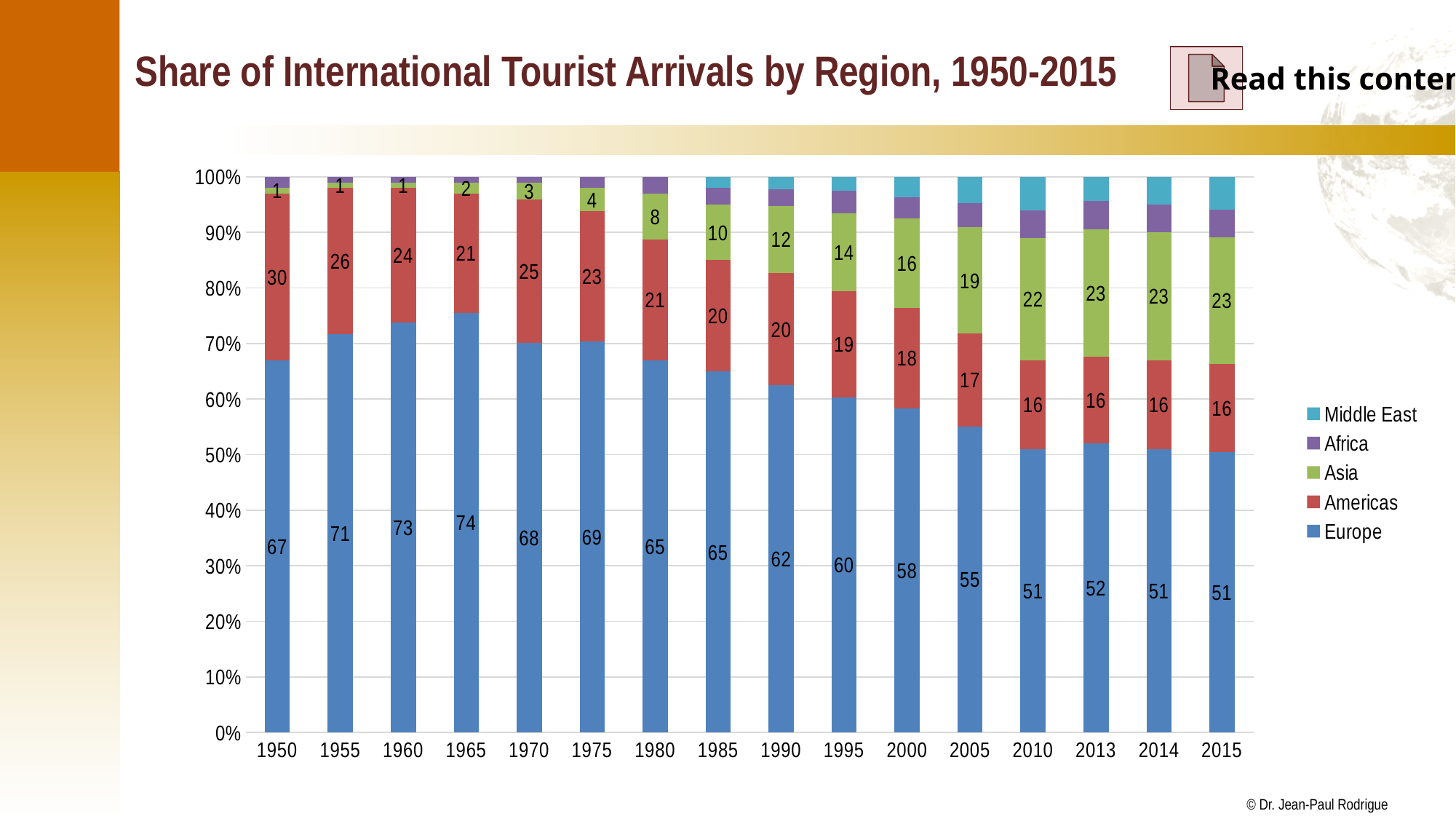
What is the title of the chart? Share of International Tourist Arrivals by Region, 1950-2015 Does the Europe share rise or fall from 1965 to 2015? Fall What is the difference between the Europe value in 1950 and in 2015? 16 How many years are shown on the x axis? 16 In which year is the Americas share highest? 1950 In 2005, which is larger, the Asia value or the Americas value? Asia How many series does the legend list? 5 What is the value for Americas in 1970? 25 What kind of chart is shown on the slide? Stacked bar chart In which year is the Europe share highest? 1965 What is the value for Asia in 2015? 23 What is the value for Europe in 1950? 67